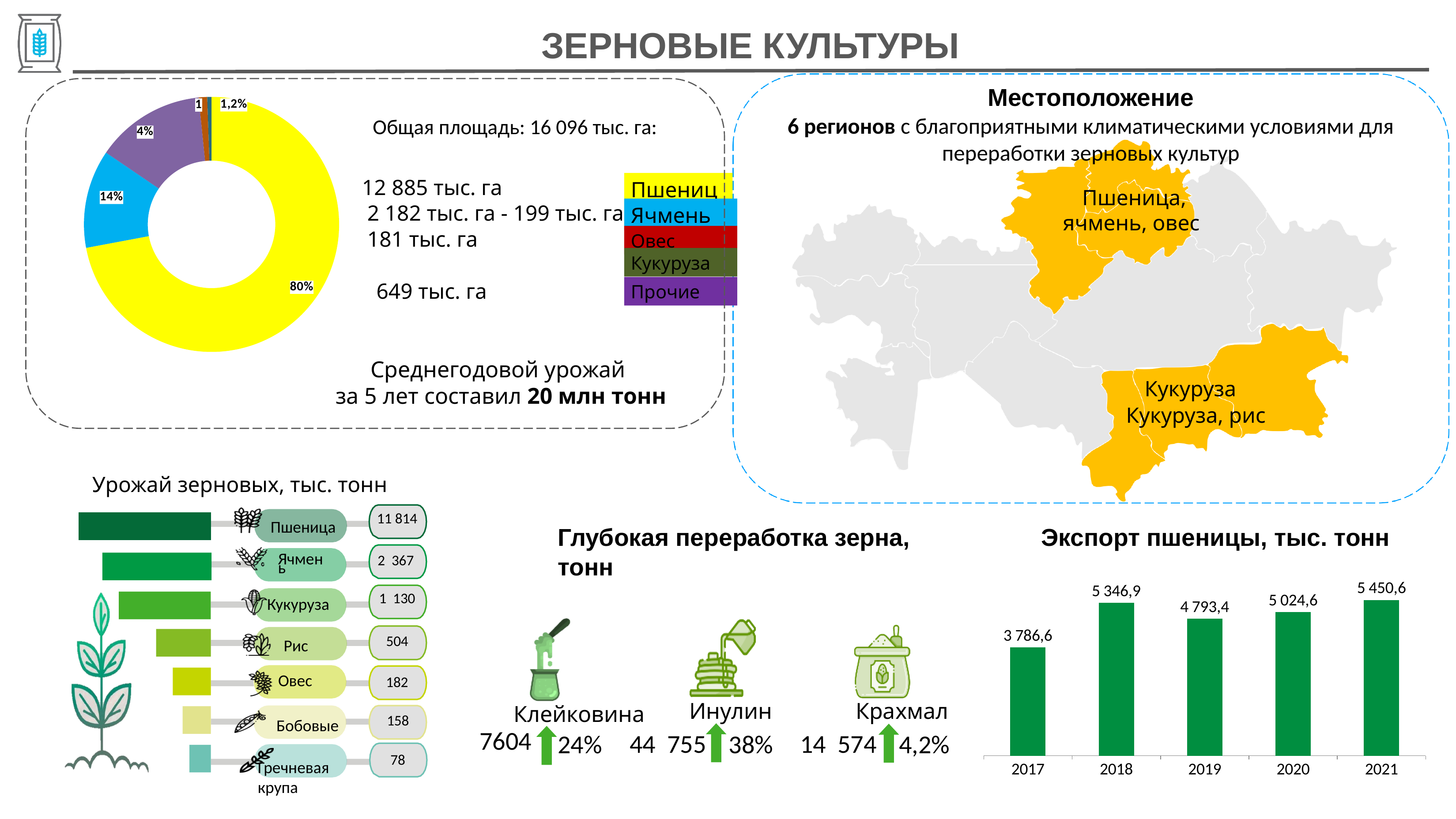
In the 'Урожай зерновых, тыс. тонн' chart, which crop has the highest value? Пшеница In the 'Экспорт пшеницы, тыс. тонн' chart, which year has the highest value? 2021 What kind of chart is 'Экспорт пшеницы, тыс. тонн'? bar chart In the 'Экспорт пшеницы, тыс. тонн' chart, which year has the lowest value? 2017 How many crops are listed in the 'Урожай зерновых, тыс. тонн' chart? 7 In the 'Экспорт пшеницы, тыс. тонн' chart, what is the difference between the 2018 and 2019 values? 553,5 In the donut chart at the top left, what share does Ячмень have? 14% In the 'Урожай зерновых, тыс. тонн' chart, what is the value for Кукуруза? 1 130 In the 'Экспорт пшеницы, тыс. тонн' chart, which is larger: the value for 2018 or 2020? 2018 How many years are shown in the 'Экспорт пшеницы, тыс. тонн' chart? 5 In the 'Урожай зерновых, тыс. тонн' chart, what is the difference between Рис and Овес? 322 In the 'Экспорт пшеницы, тыс. тонн' chart, what is the value for 2019? 4 793,4